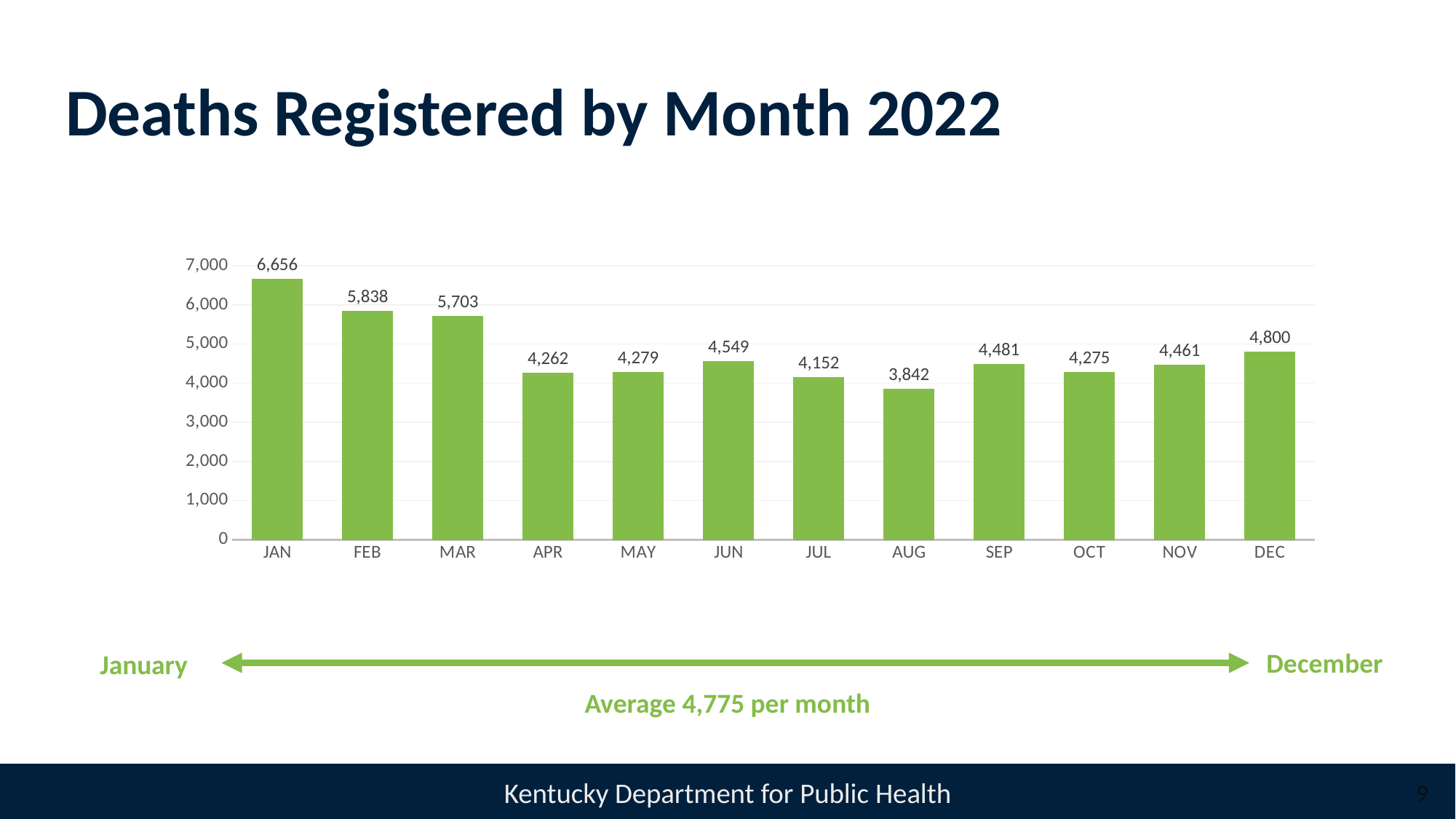
How many months are shown on the x axis? 12 Is the value for MAR greater or less than 5,000? greater Which month has the lowest number of deaths registered? AUG Which is larger, the value for JUN or the value for JUL? JUN How many deaths were registered in January 2022? 6,656 Which month has the highest number of deaths registered? JAN What is the value shown for DEC? 4,800 What kind of chart is shown on the slide? Bar chart What is the difference between the values for DEC and AUG? 958 What average per month is stated below the chart? 4,775 What is the value shown for AUG? 3,842 What is the difference between the values for JAN and FEB? 818